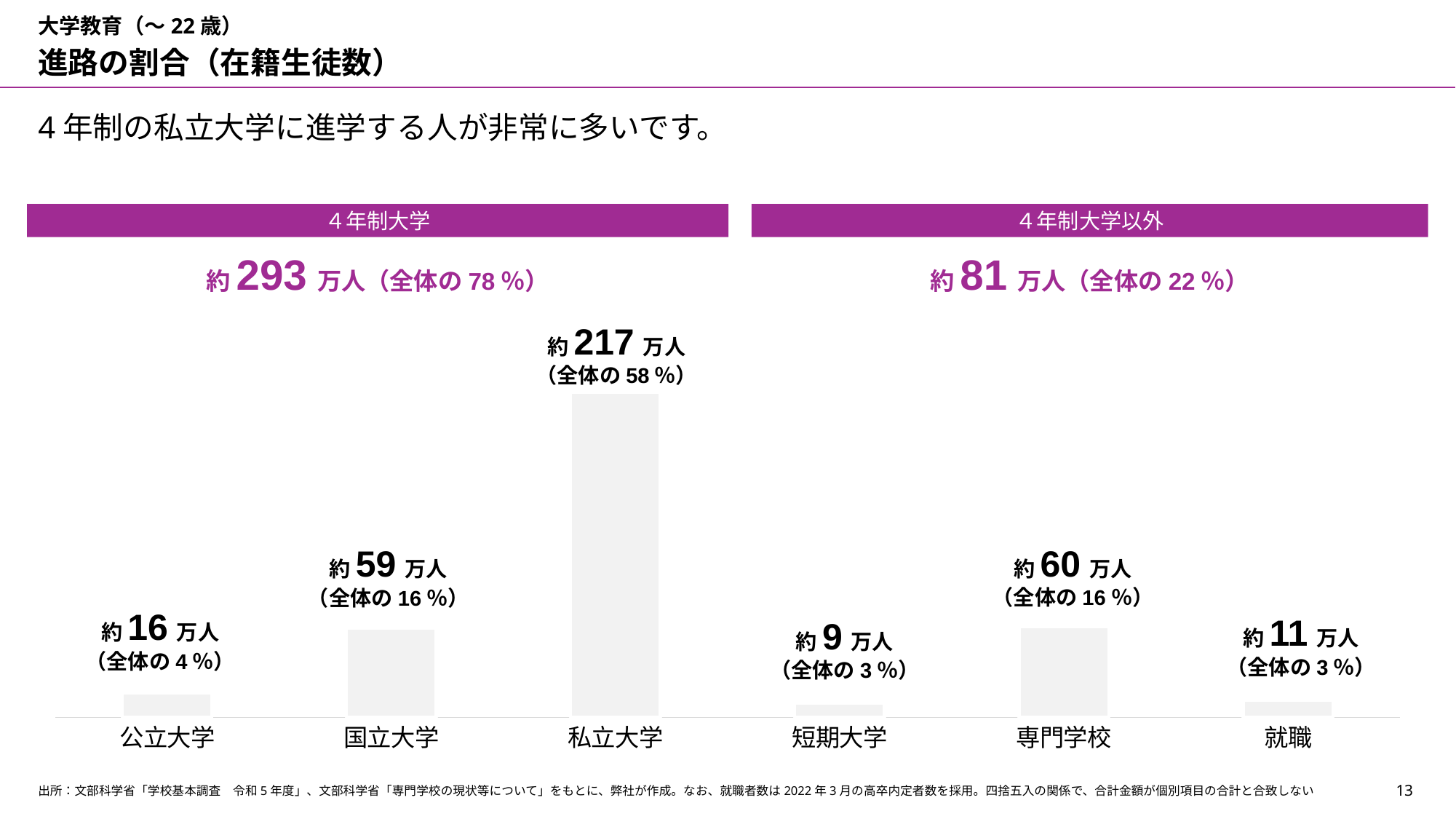
How many categories are plotted along the x axis of the chart? 6 Which is larger, the value for 私立大学 or the value for 専門学校? 私立大学 What is the value shown for 短期大学? 約 9 万人 What is the value shown for 私立大学? 約 217 万人 What is the difference between the values for 専門学校 and 国立大学? 1 万人 What total is shown for the 4年制大学以外 group? 約 81 万人（全体の 22 %） What kind of chart is shown on the slide? bar chart What is the difference between the values for 私立大学 and 国立大学? 158 万人 What share of the total does 国立大学 account for, according to its data label? 16 % What total is shown for the 4年制大学 group? 約 293 万人（全体の 78 %） Which category has the lowest value? 短期大学 Which category has the highest value? 私立大学